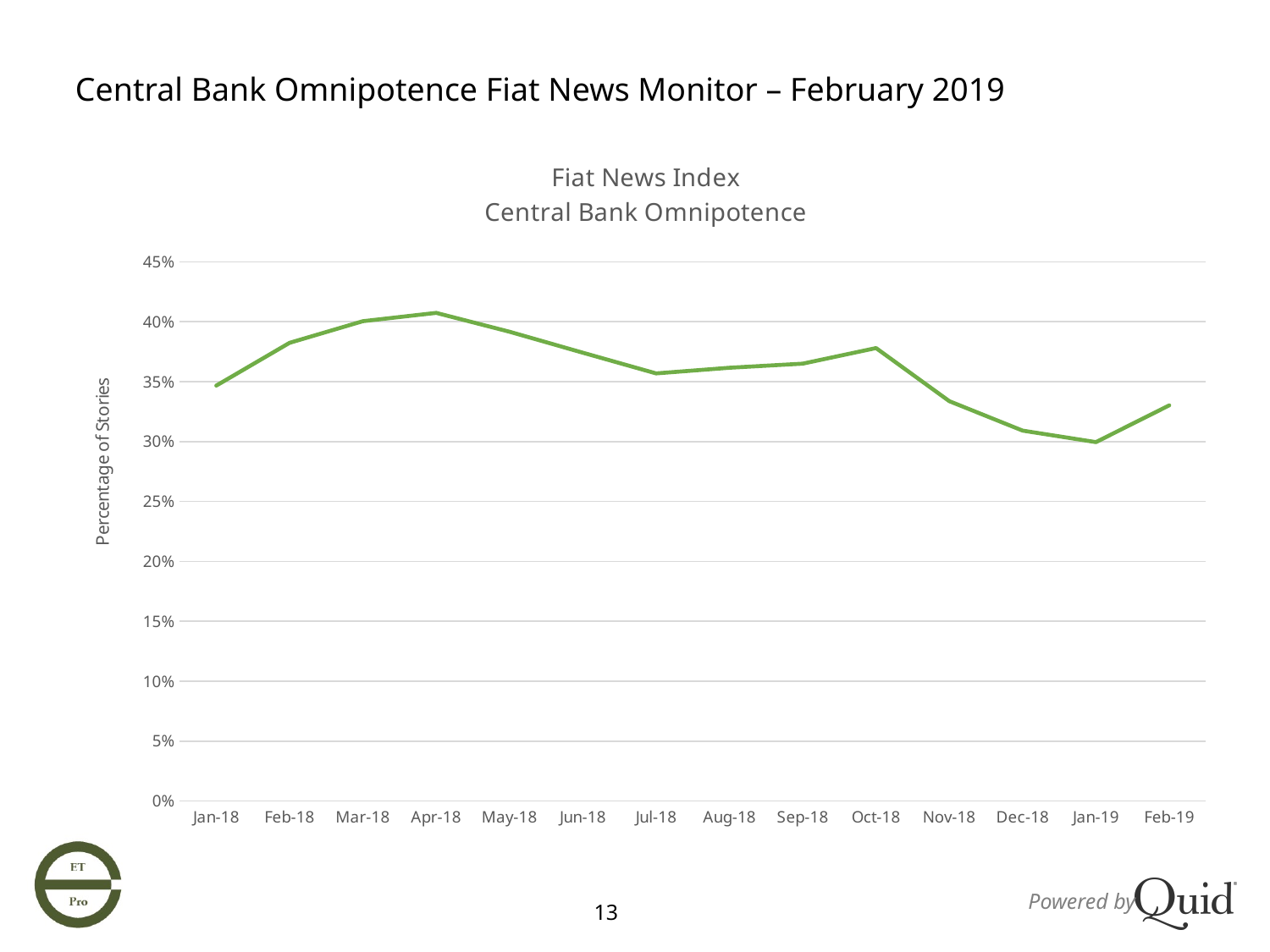
Do the values rise or fall from Oct-18 to Jan-19? Fall What kind of chart is shown on the slide? Line chart Is the value for Jan-19 greater or less than 35%? less Which month has the lowest value on the Fiat News Index chart? Jan-19 Is the value for Mar-18 greater or less than 35%? greater Which is larger, the value for Jan-18 or the value for Jan-19? Jan-18 How many monthly data points are plotted on the Fiat News Index chart? 14 Which is larger, the value for Feb-18 or the value for Jul-18? Feb-18 Is the value for Oct-18 greater or less than 35%? greater What is the label on the vertical axis of the chart? Percentage of Stories Which month has the highest value on the Fiat News Index chart? Apr-18